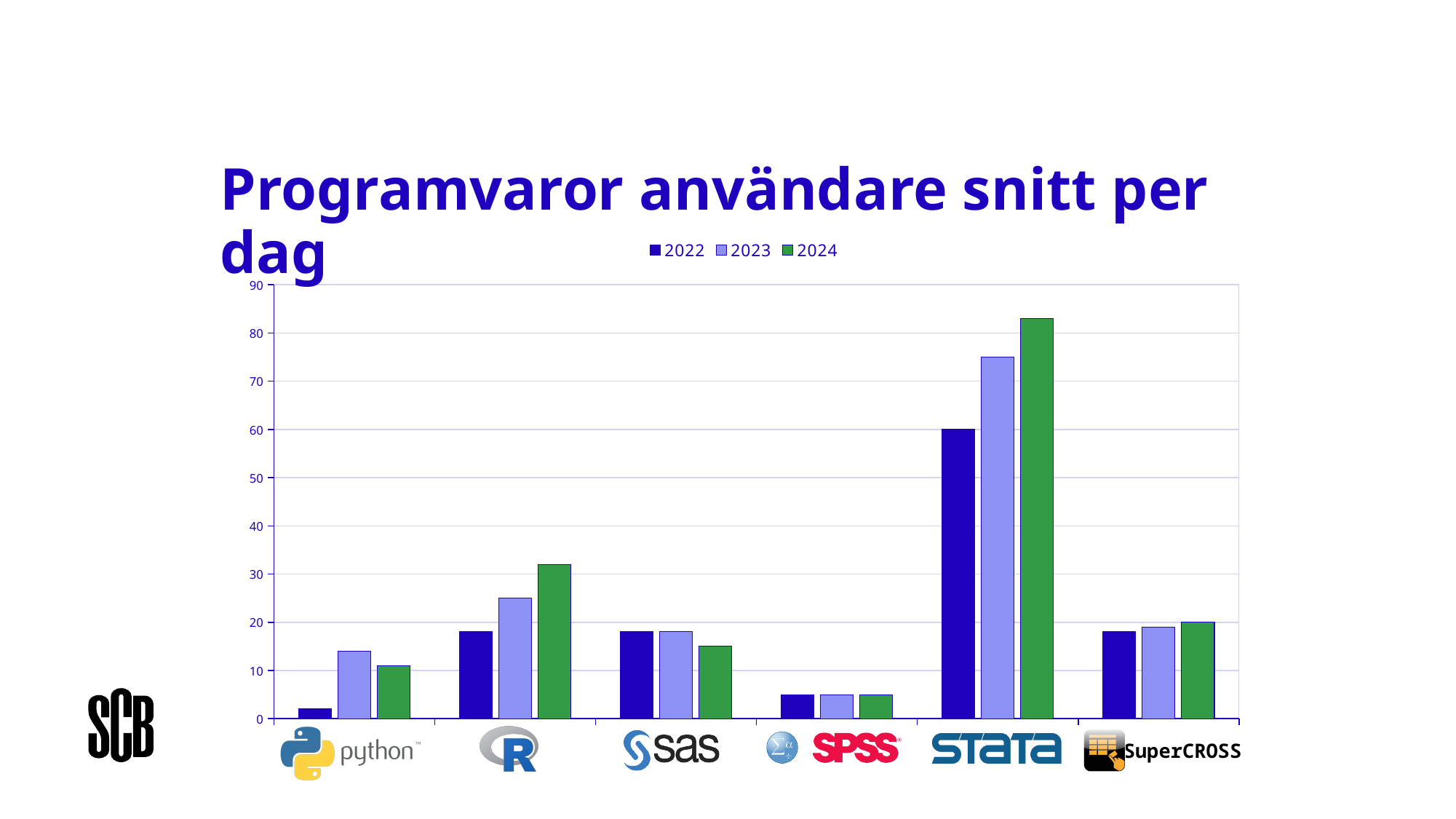
Is the value for R in 2024 greater or less than 30? greater Is the value for Stata in 2024 greater or less than 80? greater Do the values for Stata rise or fall from 2022 to 2024? rise Which has the larger value in 2024, R or SAS? R Which software has the lowest value for 2022? Python For Python, which year has the larger value, 2023 or 2024? 2023 What kind of chart is shown on the slide? bar chart Which software has the highest value for 2024? Stata Is the value for SPSS in 2024 greater or less than 10? less How many software categories are shown on the x axis? 6 How many series does the legend list? 3 What are the entries in the chart legend? 2022, 2023, 2024